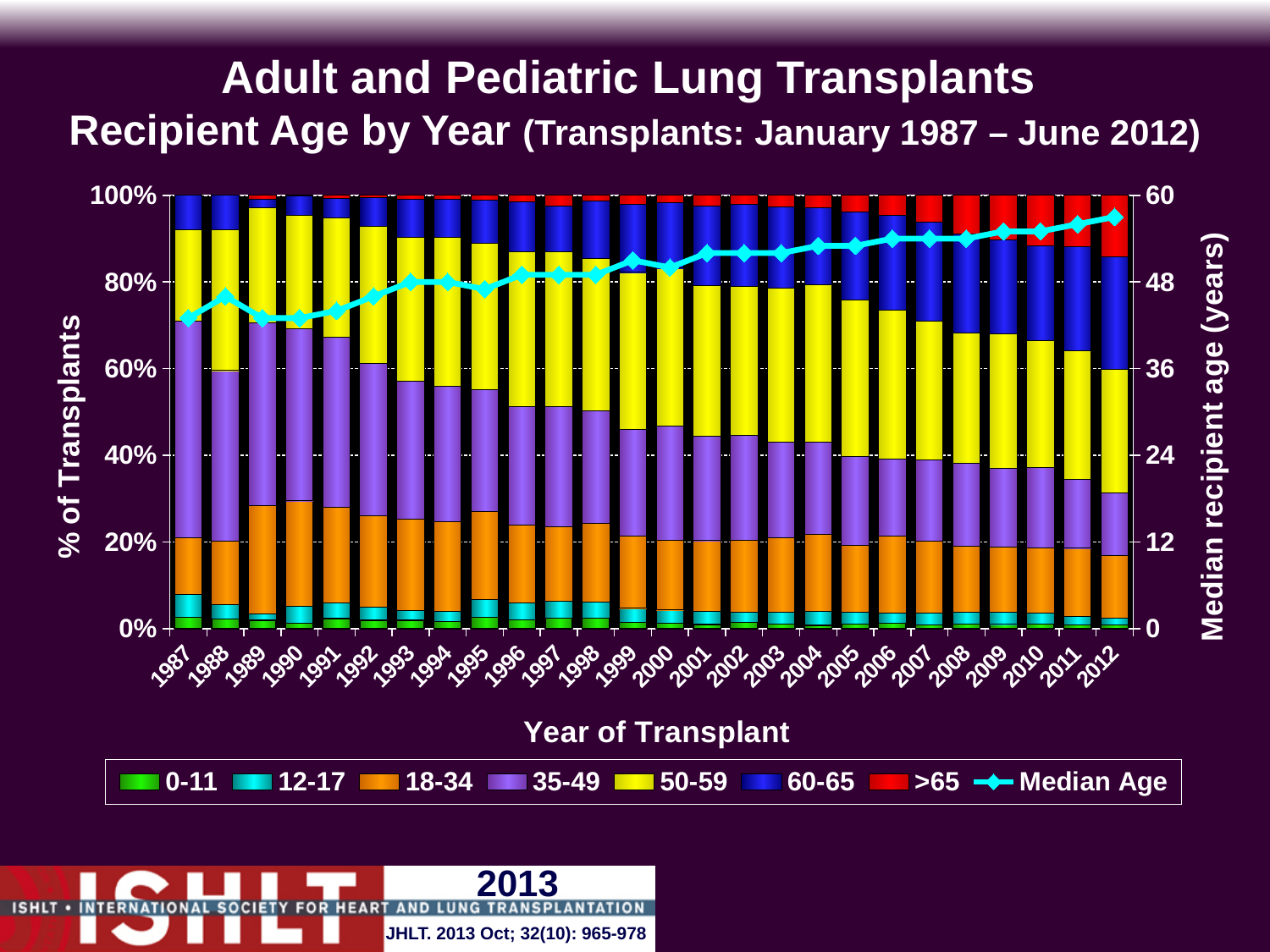
Which year has the highest median recipient age? 2012 What is the label of the right-hand y axis? Median recipient age (years) Does the median recipient age rise or fall from 1987 to 2012? Rise Is the median recipient age in 2012 greater or less than 48 years? greater Which is larger, the median recipient age in 1987 or in 2012? 2012 What kind of chart is shown on the slide? Stacked bar chart with a line for median age How many entries does the chart legend list? 8 Is the median recipient age in 1987 greater or less than 48 years? less Does the share of transplants in the 35-49 age group rise or fall from 1987 to 2012? Fall What is the title of the chart? Adult and Pediatric Lung Transplants Recipient Age by Year (Transplants: January 1987 – June 2012) How many years are shown along the x axis of the chart? 26 Is the median recipient age in 2005 greater or less than 48 years? greater